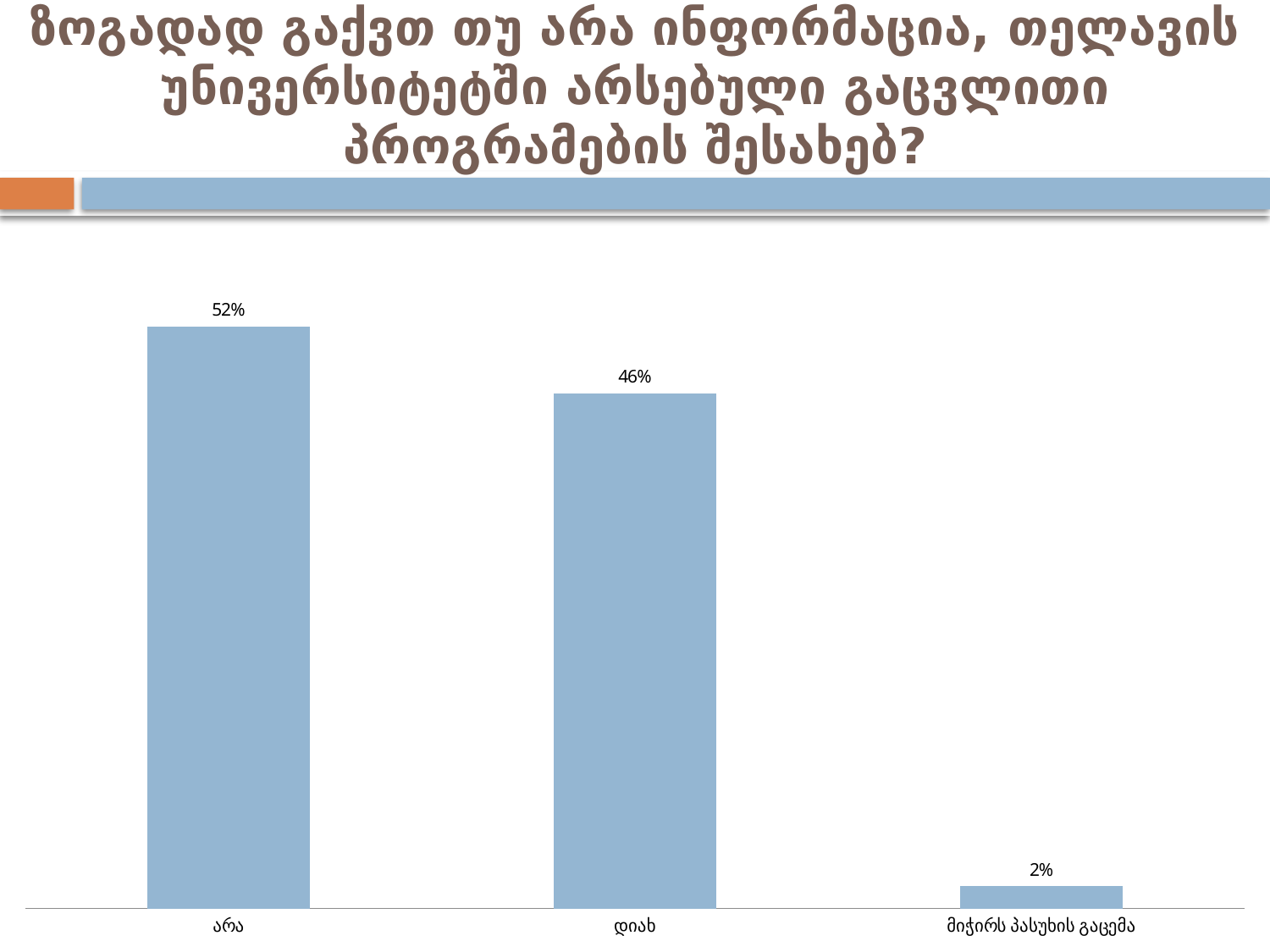
What kind of chart is shown on the slide? Bar chart Which is larger, the value for "არა" or the value for "დიახ"? არა Do the values rise or fall from left to right along the x axis? Fall What is the difference between the values for "დიახ" and "მიჭირს პასუხის გაცემა"? 44% Which category has the highest value? არა Which category has the lowest value? მიჭირს პასუხის გაცემა What colour are the bars in the chart? Light blue How many categories are shown in the chart? 3 What is the value for the category "არა"? 52% What is the value for the category "დიახ"? 46% What is the value for the category "მიჭირს პასუხის გაცემა"? 2% What is the difference between the values for "არა" and "დიახ"? 6%